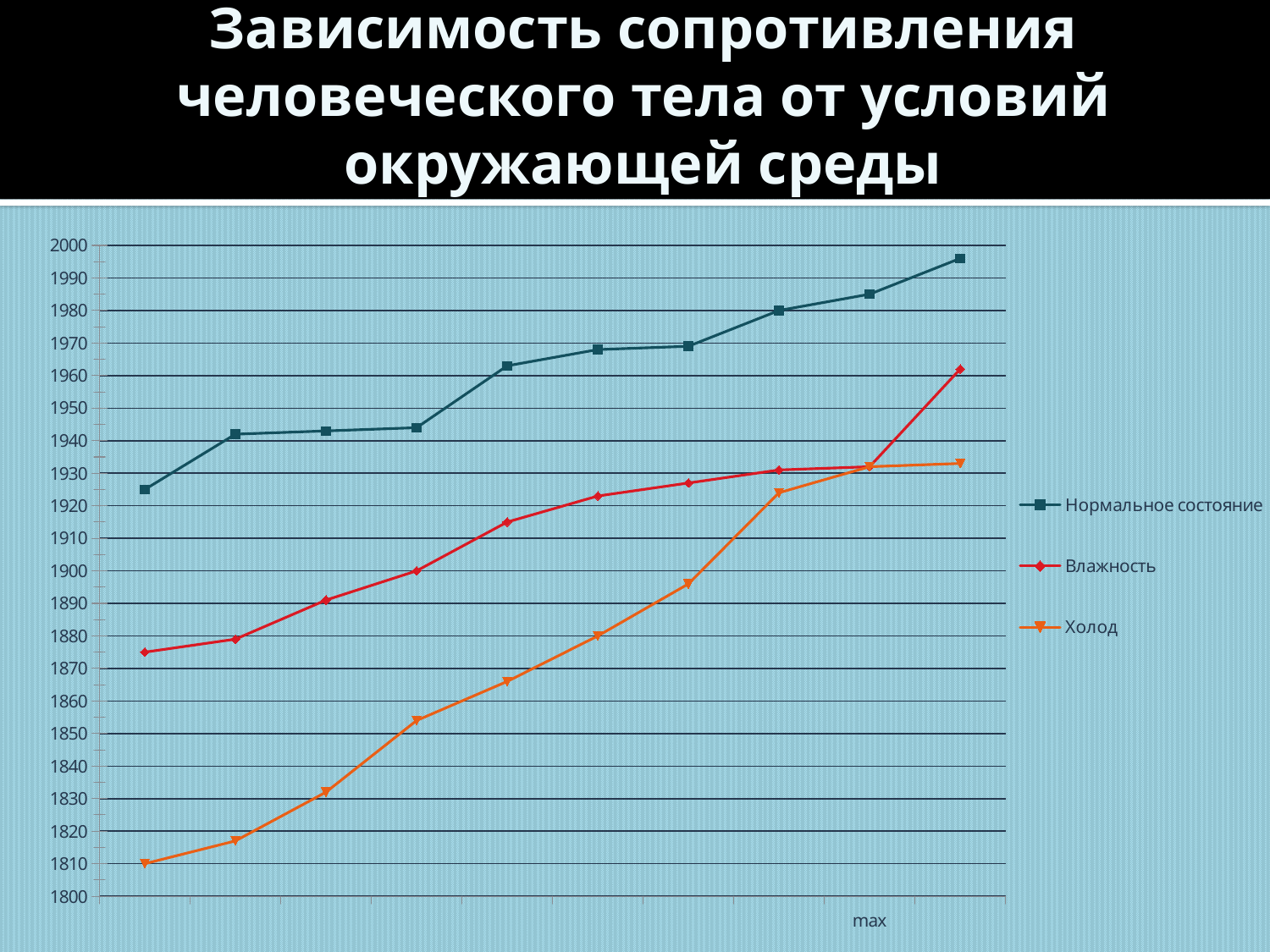
Which series is drawn in orange? Холод Is the last value of the Влажность series greater or less than 1950? greater Which series has the highest values across the chart? Нормальное состояние Is the first value of the Нормальное состояние series greater or less than 1920? greater Which series has the lowest value at the first point? Холод Is the first value of the Холод series greater or less than 1820? less How many series does the legend list? 3 What is the title of the slide containing the chart? Зависимость сопротивления человеческого тела от условий окружающей среды How many data points does the Нормальное состояние series have? 10 What kind of chart is shown on the slide? line chart Do the values of the Холод series rise or fall along the x axis? rise At the last point, which series is higher: Влажность or Холод? Влажность